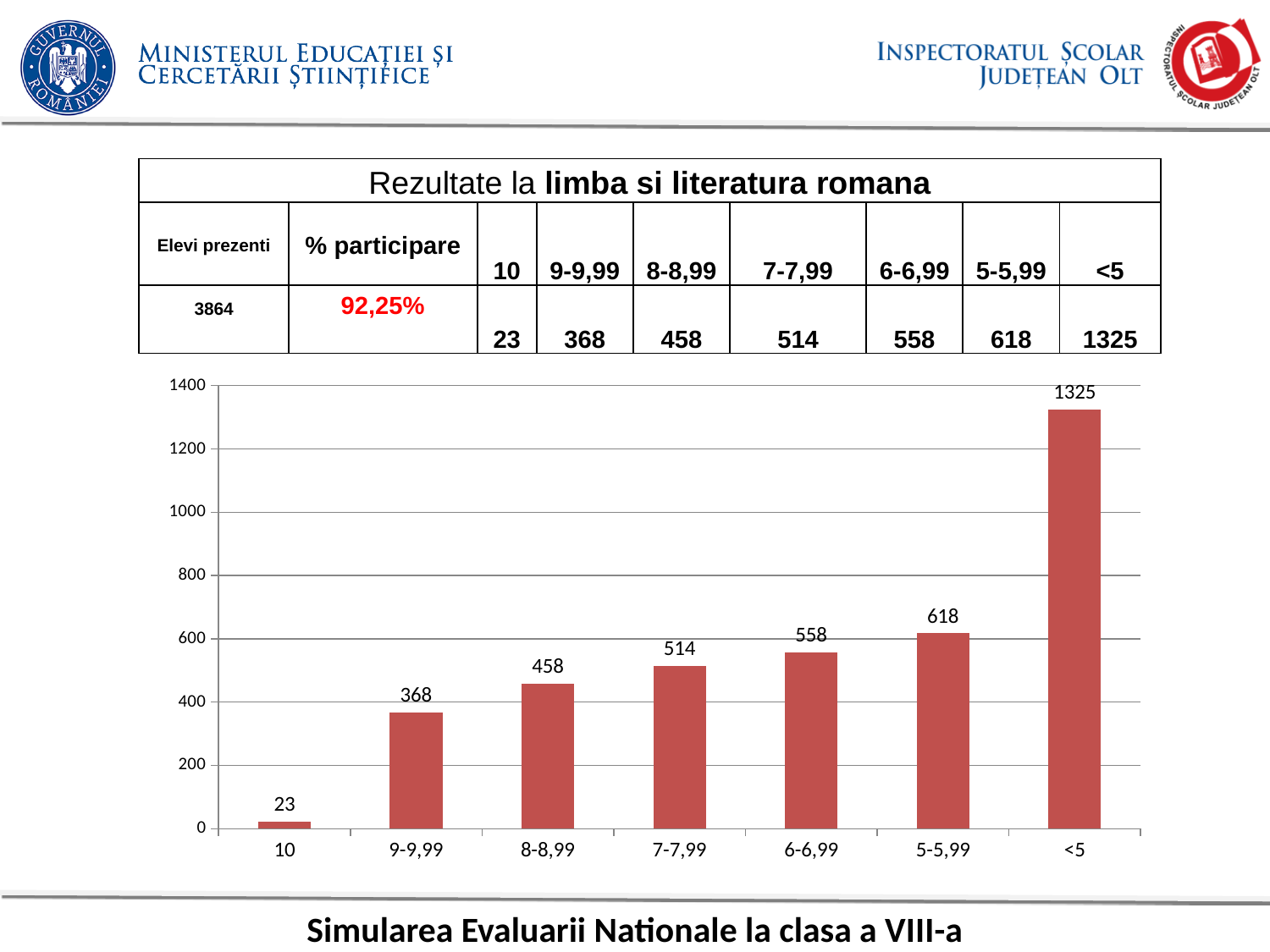
Which is larger, the value for 7-7,99 or the value for 8-8,99? 7-7,99 What kind of chart is shown on the slide? bar chart Which category has the lowest value? 10 Do the values rise or fall from left to right along the x axis? rise What is the value for the <5 category? 1325 What is the difference between the values for 5-5,99 and 6-6,99? 60 What is the difference between the values for <5 and 9-9,99? 957 What is the value for the 10 category? 23 What is the value for the 8-8,99 category? 458 Which category has the highest value? <5 How many categories are shown on the x axis? 7 Is the value for 6-6,99 greater or less than 600? less